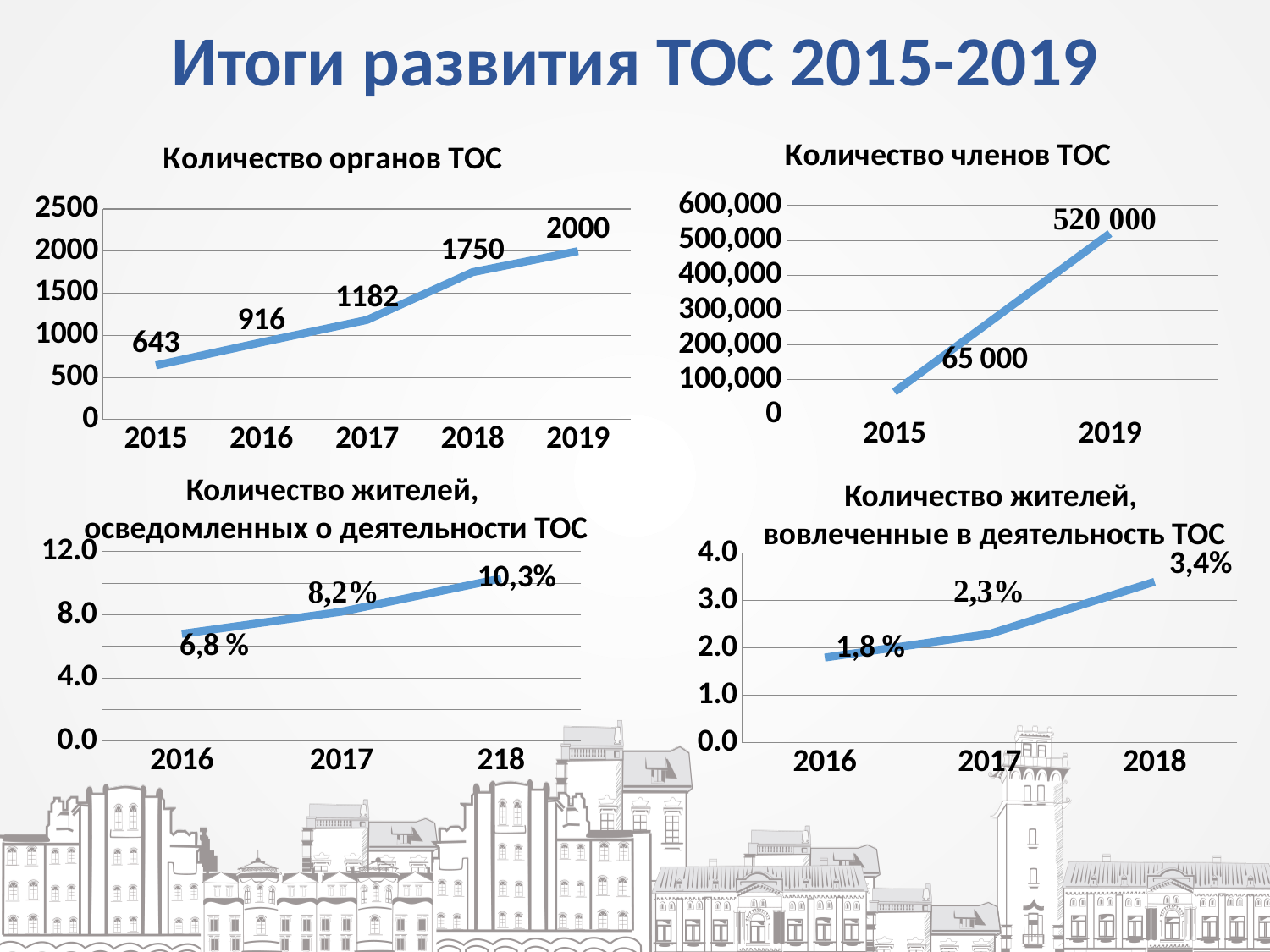
In the chart titled "Количество членов ТОС", what is the value for 2015? 65 000 In the chart titled "Количество членов ТОС", what is the value for 2019? 520 000 In the chart titled "Количество жителей, осведомленных о деятельности ТОС", which year has the lowest value? 2016 In the chart titled "Количество жителей, вовлеченные в деятельность ТОС", what is the value for 2018? 3,4% In the chart titled "Количество органов ТОС", how many years are plotted on the x axis? 5 What type of chart is the chart titled "Количество жителей, вовлеченные в деятельность ТОС"? line chart In the chart titled "Количество органов ТОС", what is the value for 2019? 2000 In the chart titled "Количество членов ТОС", is the value for 2019 greater or less than 500,000? greater In the chart titled "Количество жителей, осведомленных о деятельности ТОС", what is the value for 2017? 8,2% In the chart titled "Количество органов ТОС", do the values rise or fall from 2015 to 2019? rise In the chart titled "Количество органов ТОС", what is the value for 2017? 1182 In the chart titled "Количество органов ТОС", what is the difference between the 2018 and 2017 values? 568